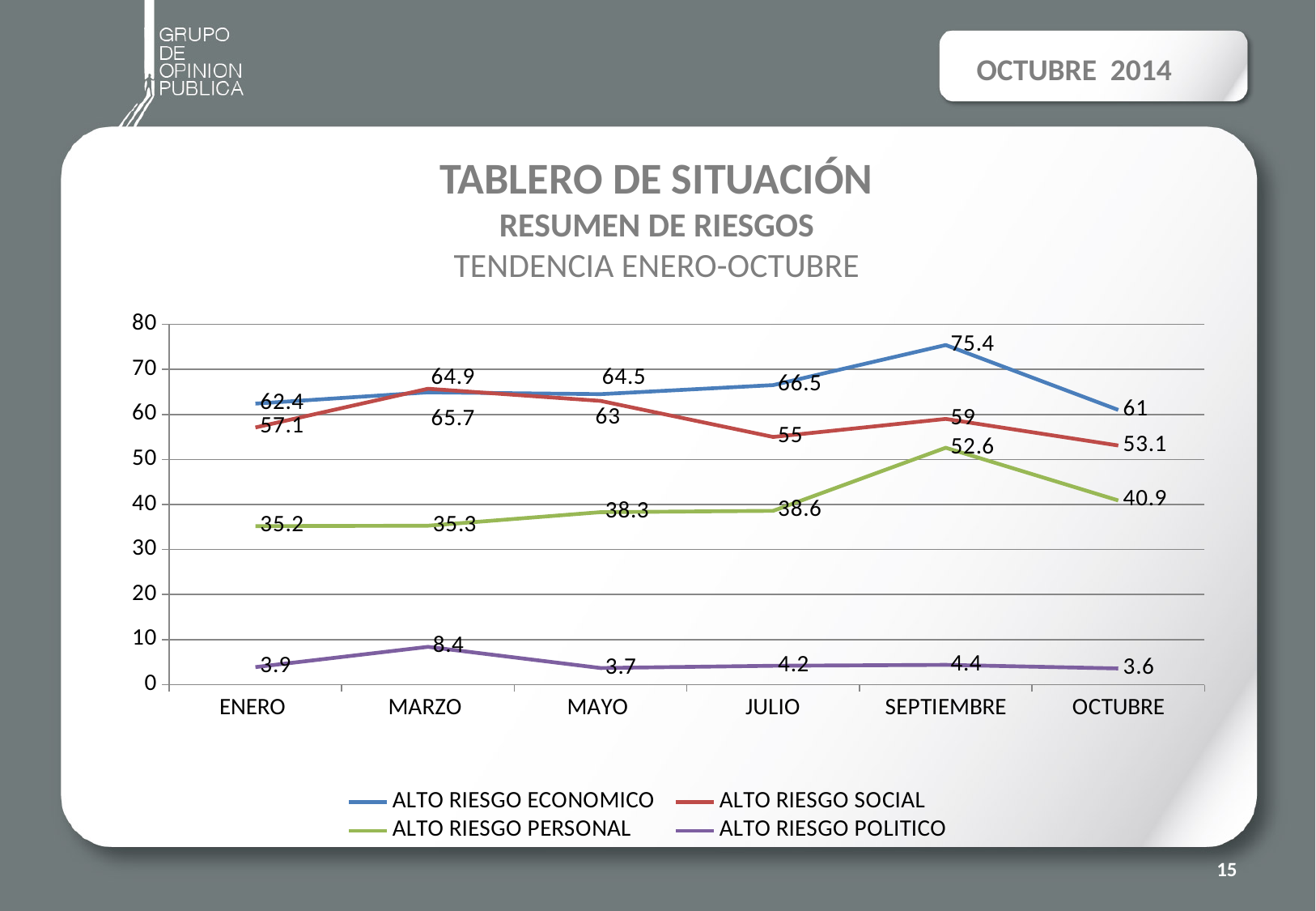
What type of chart is shown on the slide? line chart How many months are shown on the x axis? 6 What is the value of ALTO RIESGO POLITICO in MARZO? 8.4 Which is larger in JULIO: ALTO RIESGO ECONOMICO or ALTO RIESGO SOCIAL? ALTO RIESGO ECONOMICO Does ALTO RIESGO PERSONAL rise or fall from JULIO to SEPTIEMBRE? rise What is the value of ALTO RIESGO PERSONAL in ENERO? 35.2 What is the value of ALTO RIESGO SOCIAL in OCTUBRE? 53.1 How many series does the legend list? 4 What is the value of ALTO RIESGO ECONOMICO in SEPTIEMBRE? 75.4 In which month is ALTO RIESGO SOCIAL at its lowest value? OCTUBRE What is the difference between ALTO RIESGO ECONOMICO in SEPTIEMBRE and in OCTUBRE? 14.4 In which month does ALTO RIESGO PERSONAL reach its highest value? SEPTIEMBRE